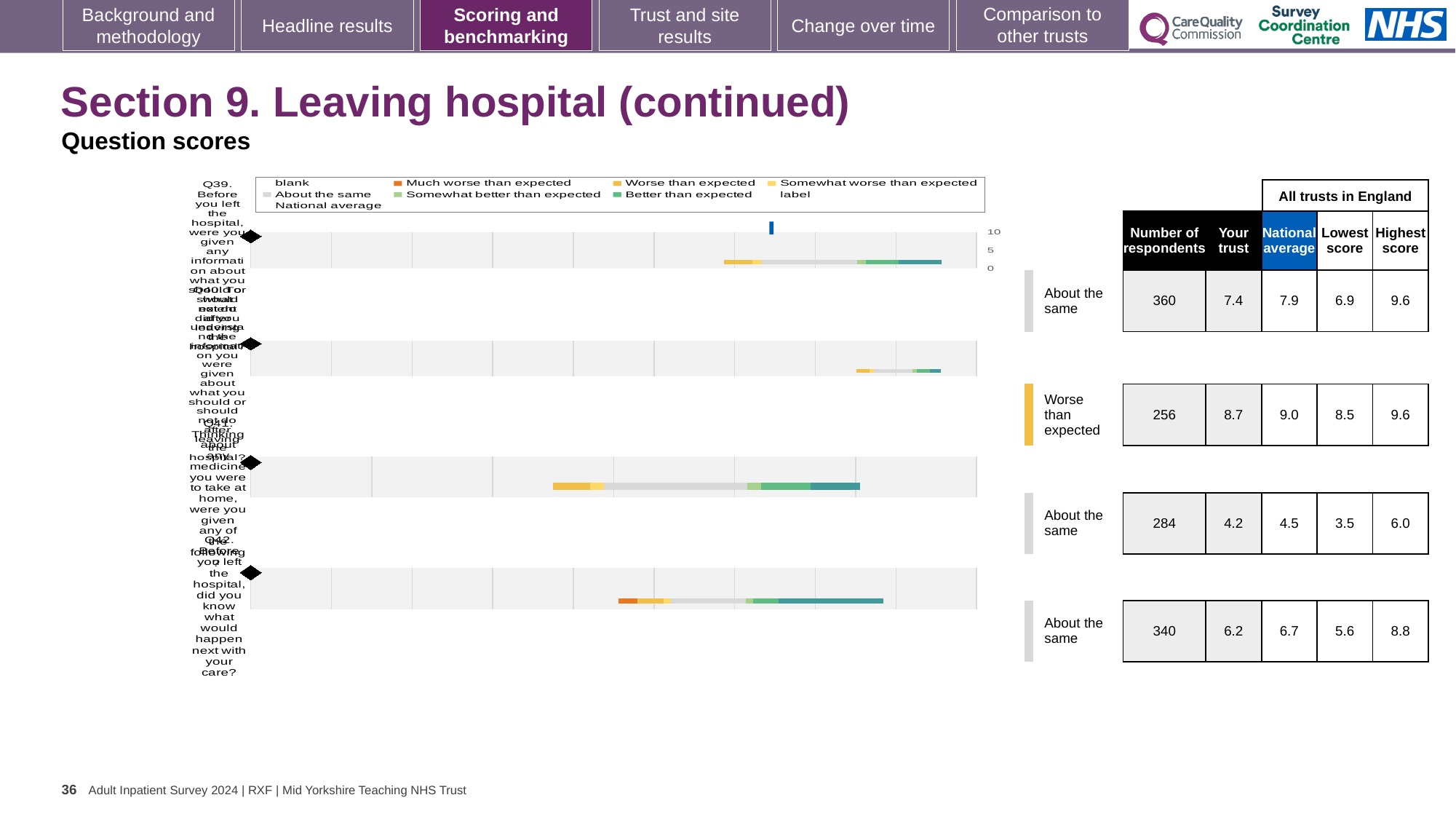
Which question has the highest 'Your trust' score? Q40 What kind of chart is used to show the question scores on this slide? Bar chart What colour represents 'Better than expected' in the chart legend? Teal Is the trust score marker for Q41 greater or less than 5 on the chart axis? less What is the difference between the national average and the 'Your trust' score for Q42? 0.5 What is the national average score for Q41? 4.5 Which question has the lowest 'Your trust' score? Q41 How many questions (bars) are plotted in the chart? 4 How many entries does the chart legend list? 9 What is the 'Your trust' score for Q39? 7.4 What colour represents 'Much worse than expected' in the chart legend? Orange Which benchmark category is shown for Q40? Worse than expected